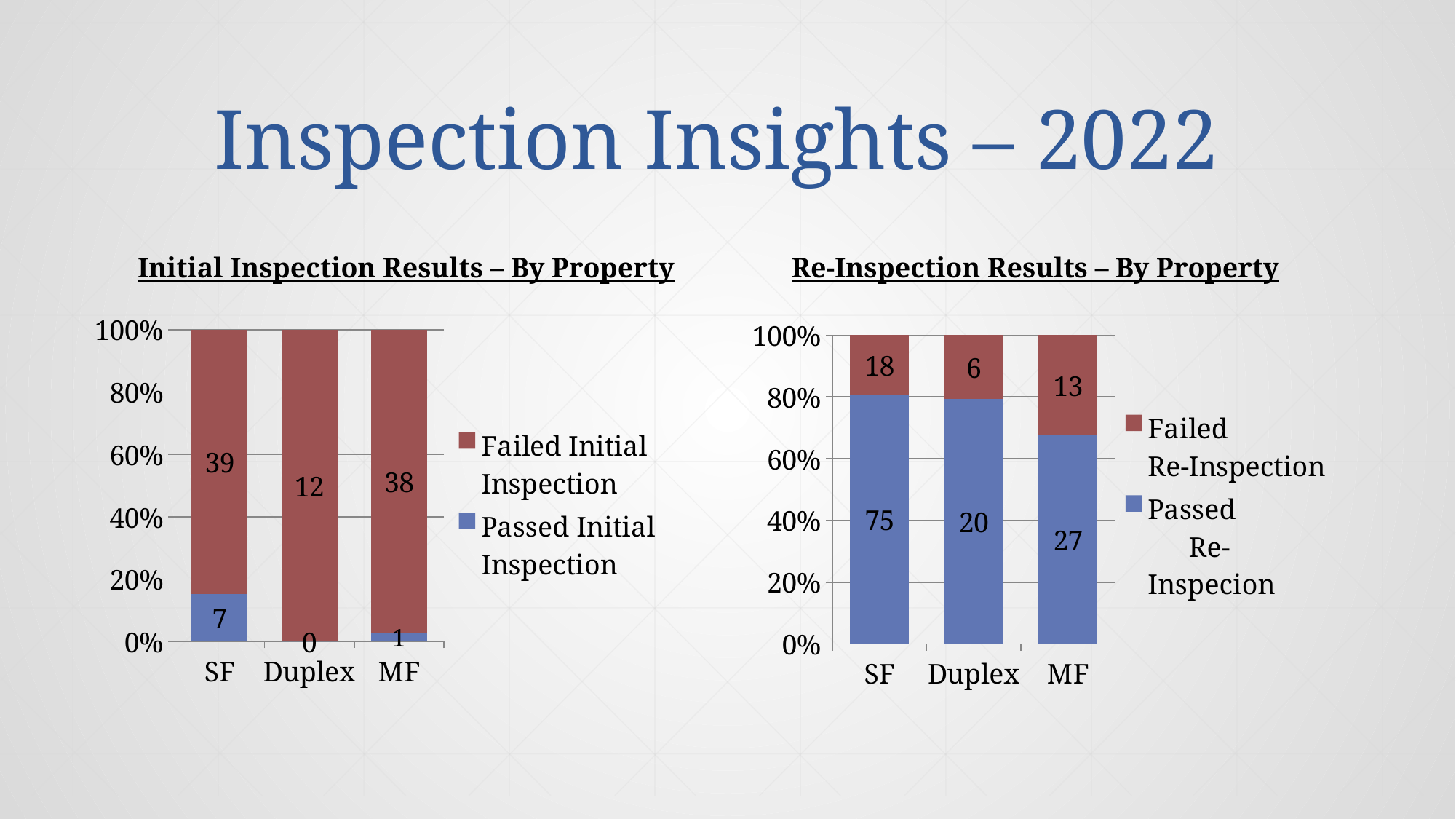
In the Initial Inspection Results chart, what is the total number of MF properties inspected (passed plus failed)? 39 In the Re-Inspection Results chart, which property type has the lowest number of failed re-inspections? Duplex What type of chart is the Initial Inspection Results chart? Stacked bar chart In the Re-Inspection Results chart, how many MF properties passed re-inspection? 27 In the Re-Inspection Results chart, how many Duplex properties failed re-inspection? 6 How many property categories are shown on the x axis of the Re-Inspection Results chart? 3 In the Re-Inspection Results chart, is the passed share for MF greater or less than 60%? greater In the Initial Inspection Results chart, is the passed share for SF greater or less than 20%? less In the Initial Inspection Results chart, how many SF properties failed the initial inspection? 39 In the Re-Inspection Results chart, what is the difference between the number of SF properties that passed and the number that failed re-inspection? 57 In the Initial Inspection Results chart, how many Duplex properties passed the initial inspection? 0 In the Initial Inspection Results chart, which property type has the highest number of failed initial inspections? SF